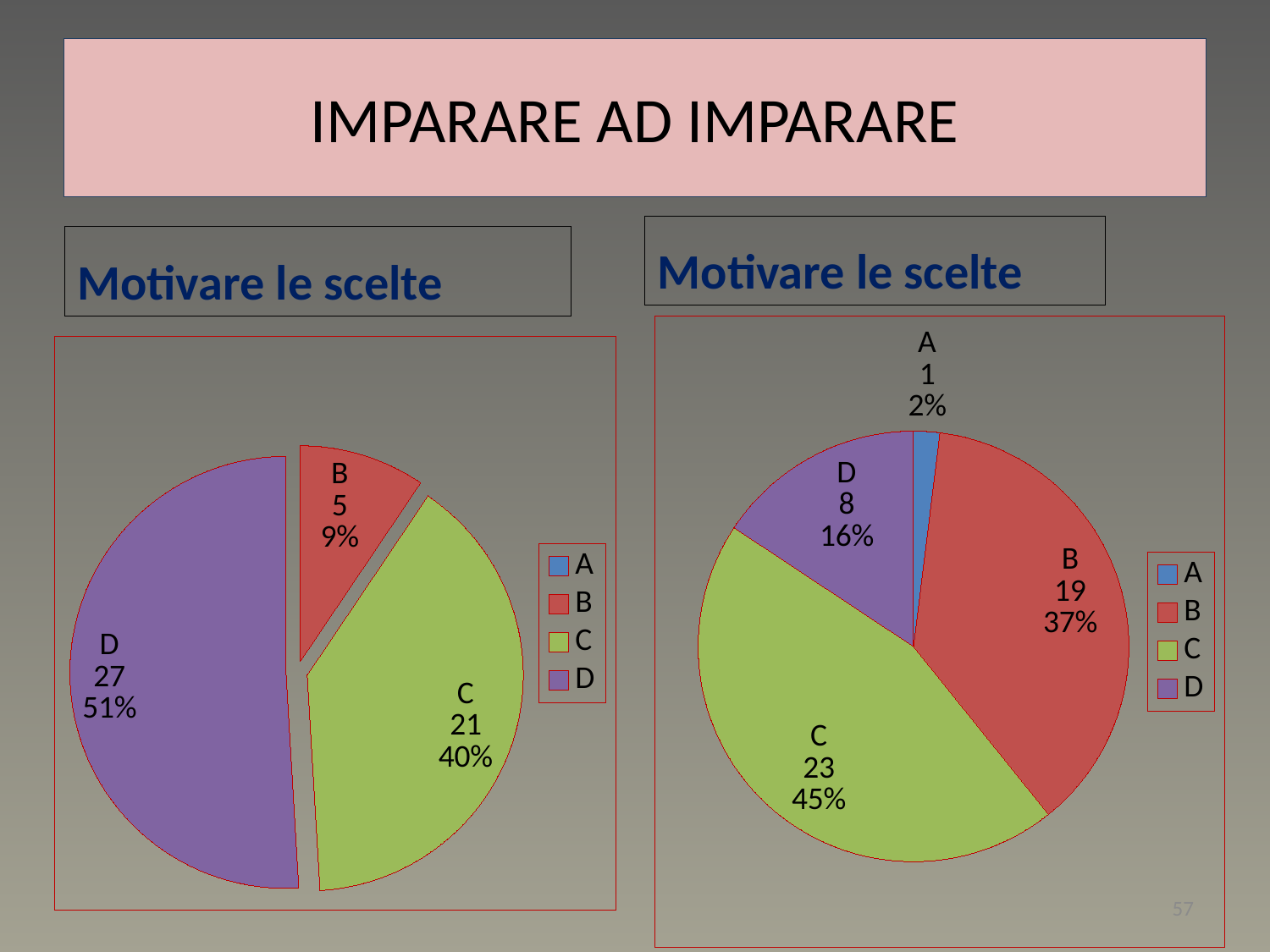
In the right pie chart, what is the value for category B? 19 In the left pie chart, which category has the largest slice? D How many entries does the legend of the right pie chart list? 4 In the left pie chart, what is the difference between the values for D and B? 22 In the right pie chart, what is the difference between the values for C and B? 4 In the right pie chart, which category has the smallest slice? A In the left pie chart, what percentage share does category C have? 40% In the right pie chart, which category has the largest slice? C In the left pie chart, what is the value for category D? 27 In the right pie chart, what percentage share does category D have? 16% What type of chart is shown on the left side of the slide? Pie chart In the right pie chart, which is larger, the value for B or the value for D? B